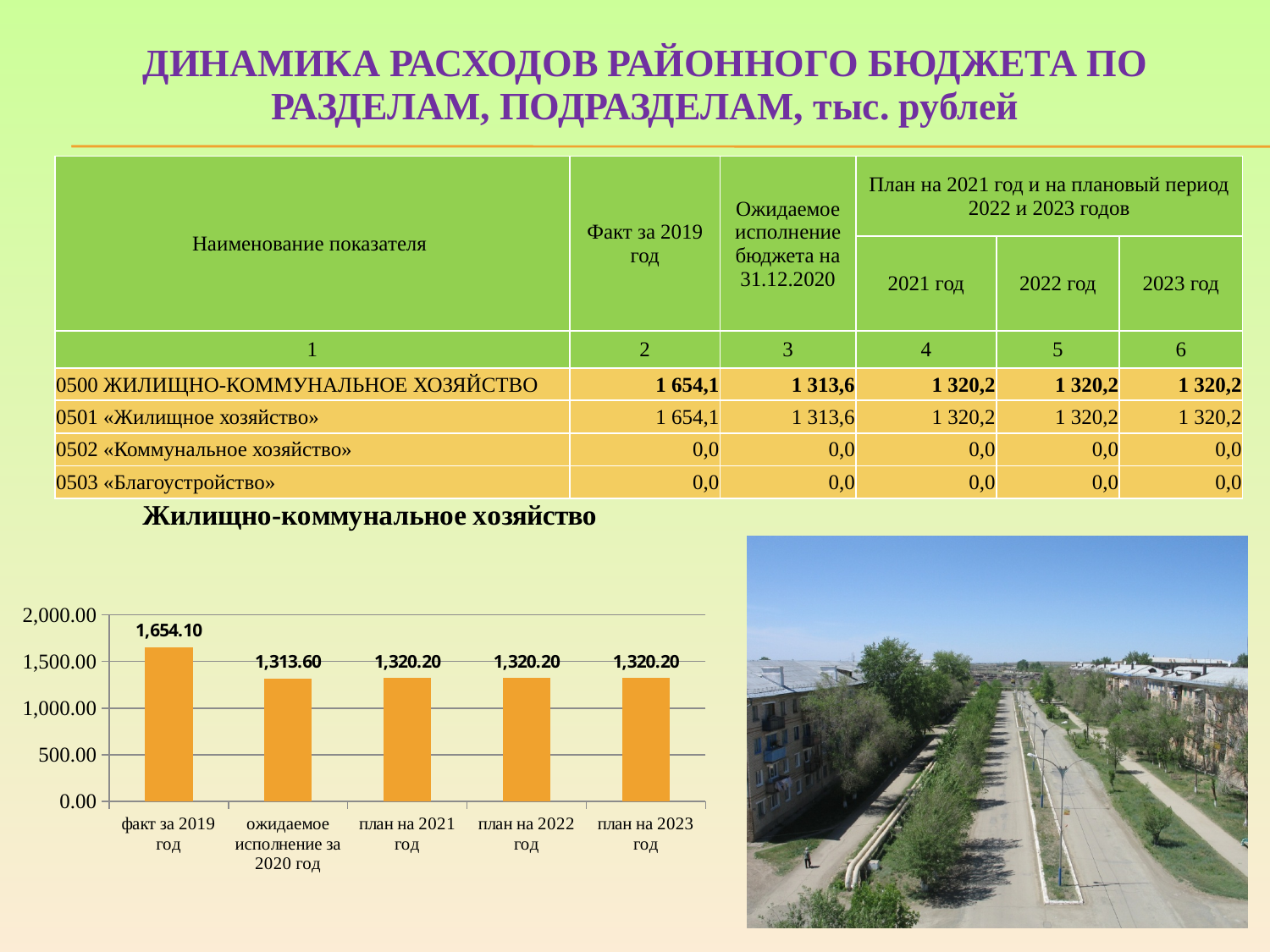
Which is larger: the value for факт за 2019 год or the value for план на 2022 год? факт за 2019 год What is the value for ожидаемое исполнение за 2020 год in the chart? 1,313.60 How many bars are shown in the chart? 5 What is the value for план на 2023 год in the chart? 1,320.20 Which category has the lowest value in the chart? ожидаемое исполнение за 2020 год Is the value for план на 2022 год greater or less than 1,500.00? less What is the title of the chart on the slide? Жилищно-коммунальное хозяйство What is the difference between the value for план на 2021 год and the value for ожидаемое исполнение за 2020 год? 6.60 What type of chart is shown on the slide? bar chart Which category has the highest value in the chart? факт за 2019 год What is the value for факт за 2019 год in the chart? 1,654.10 What is the difference between the value for факт за 2019 год and the value for план на 2021 год? 333.90